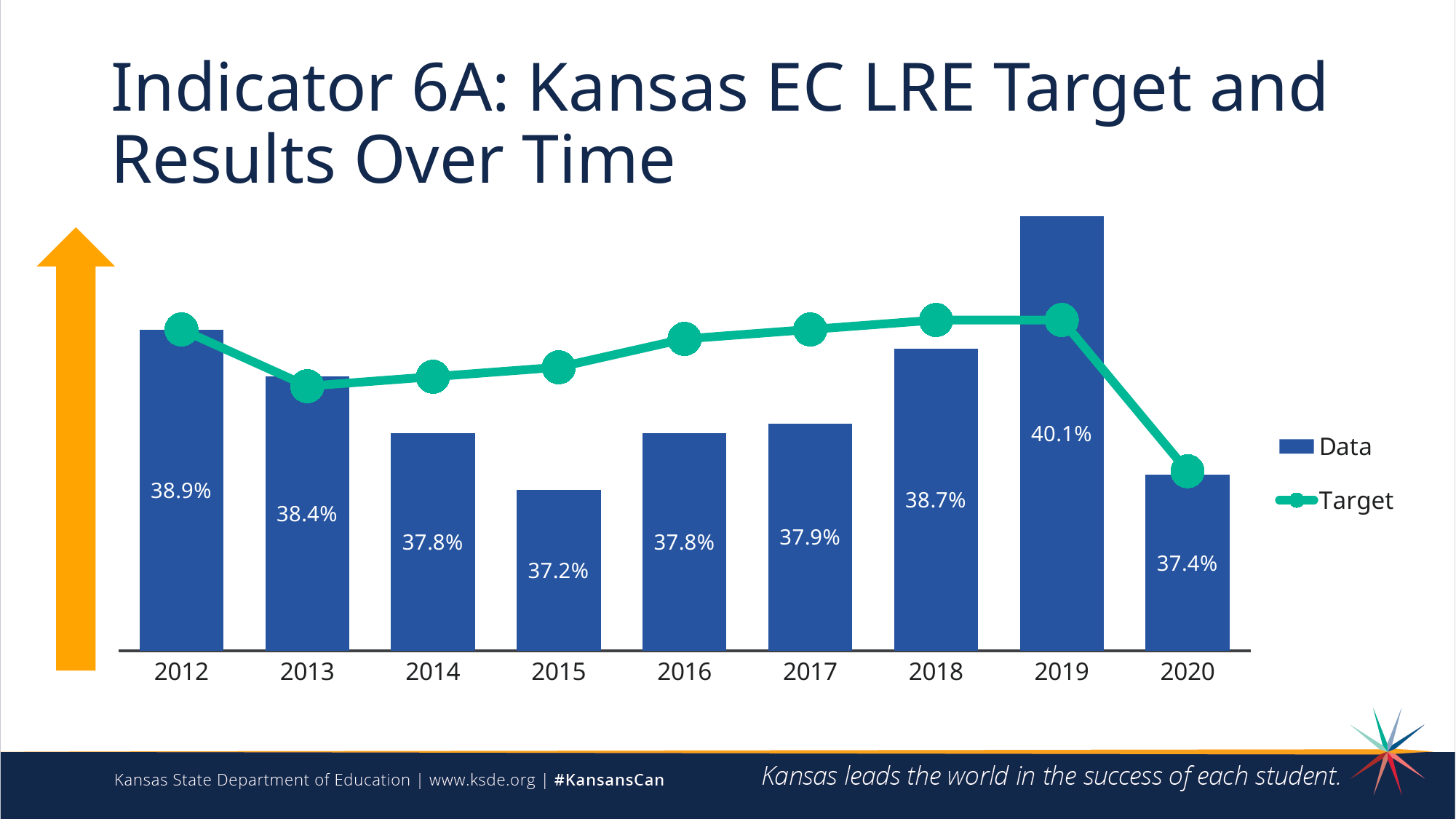
What is the Data value for 2019? 40.1% What is the difference between the Data values for 2019 and 2018? 1.4% How many series does the legend list? 2 What is the Data value for 2020? 37.4% What is the Data value for 2015? 37.2% What kind of chart is used to show the Data series? Bar chart Which year has the lowest Data value? 2015 How many years are shown on the x axis? 9 What is the Data value for 2012? 38.9% Which year has the highest Data value? 2019 Which year has a larger Data value, 2013 or 2017? 2013 What are the two entries in the legend? Data and Target